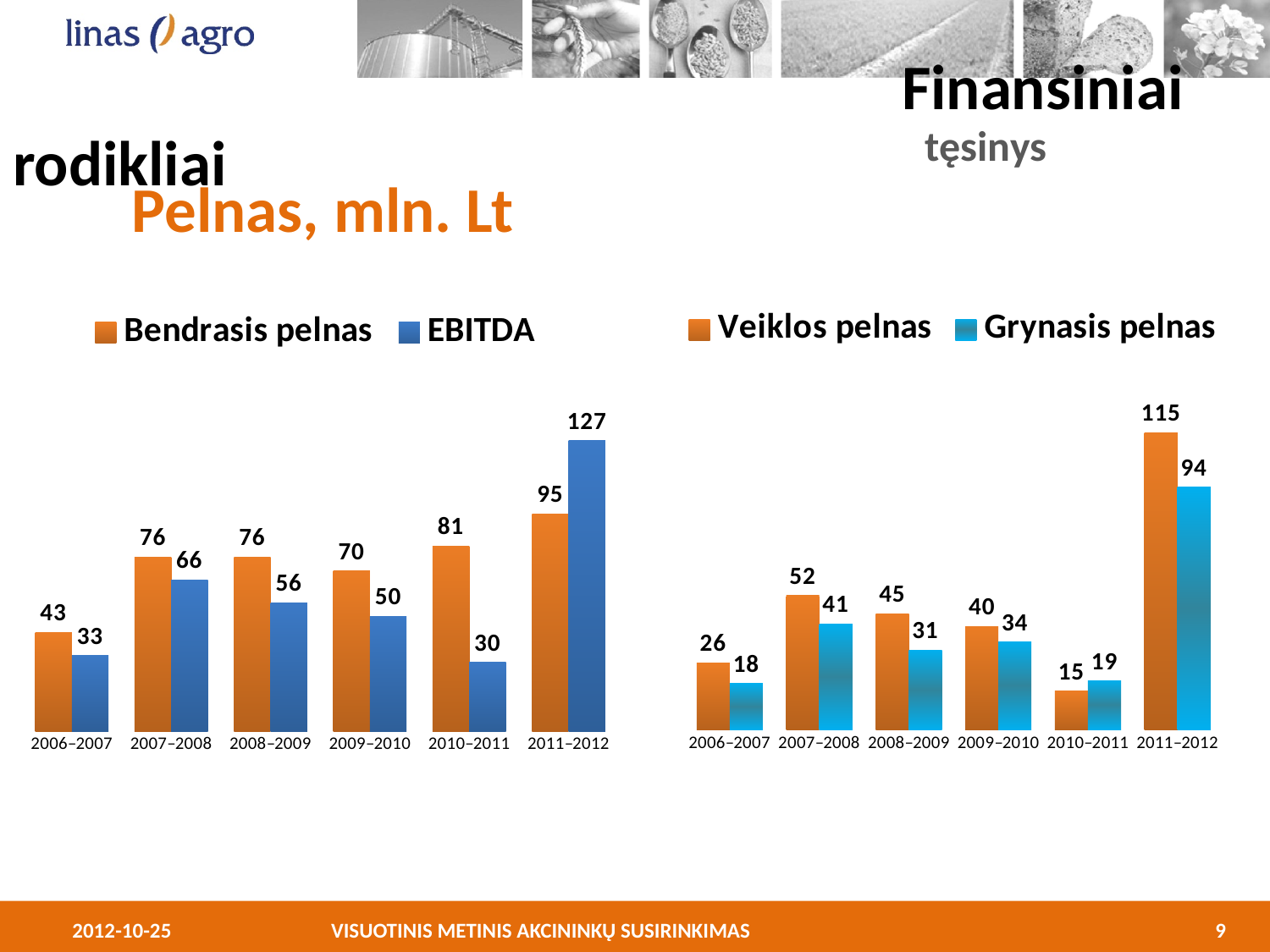
In the right chart, what is the Veiklos pelnas value for 2007–2008? 52 In the right chart, which is larger in 2010–2011: Veiklos pelnas or Grynasis pelnas? Grynasis pelnas In the right chart, what is the difference between Veiklos pelnas and Grynasis pelnas in 2011–2012? 21 In the left chart, which period has the highest EBITDA value? 2011–2012 In the right chart, what is the Grynasis pelnas value for 2009–2010? 34 How many series does the legend of the right chart list? 2 How many periods are shown on the x axis of the left chart? 6 In the left chart, what is the Bendrasis pelnas value for 2011–2012? 95 In the left chart, what is the difference between EBITDA and Bendrasis pelnas in 2011–2012? 32 In the left chart, what is the EBITDA value for 2010–2011? 30 What type of chart is the left chart? Bar chart In the right chart, which period has the lowest Veiklos pelnas value? 2010–2011